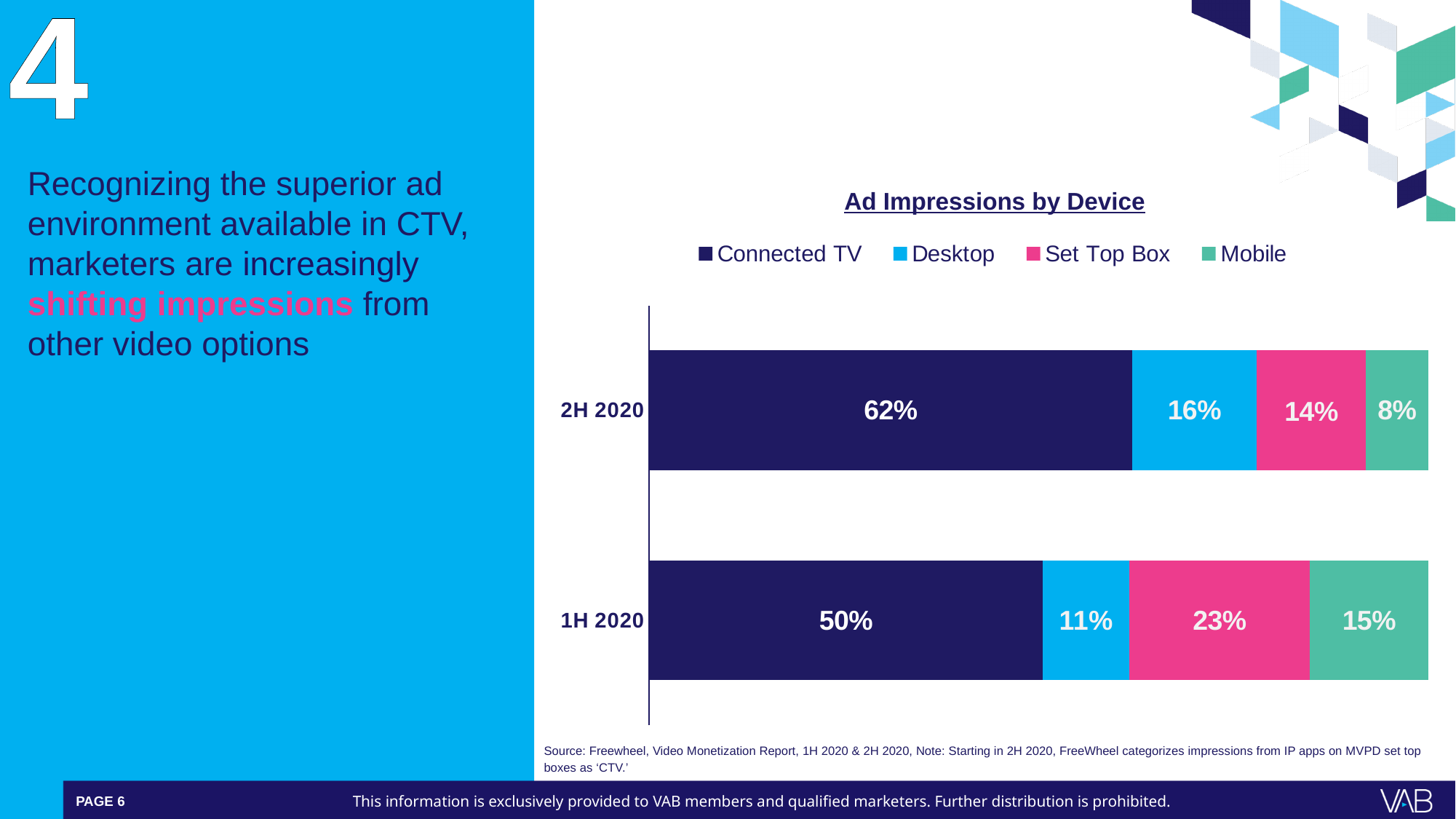
What kind of chart is shown on the slide? Stacked bar chart Which device has the smallest share of ad impressions in 2H 2020? Mobile What is the Set Top Box share of ad impressions in 1H 2020? 23% How many series does the legend list? 4 What is the title of the chart? Ad Impressions by Device How many time periods are shown on the chart? 2 By how many percentage points did the Connected TV share increase from 1H 2020 to 2H 2020? 12 What is the Connected TV share of ad impressions in 2H 2020? 62% Which device has the largest share of ad impressions in 1H 2020? Connected TV Which is larger: the Set Top Box share in 1H 2020 or the Set Top Box share in 2H 2020? 1H 2020 What is the Mobile share of ad impressions in 2H 2020? 8% What is the Desktop share of ad impressions in 1H 2020? 11%